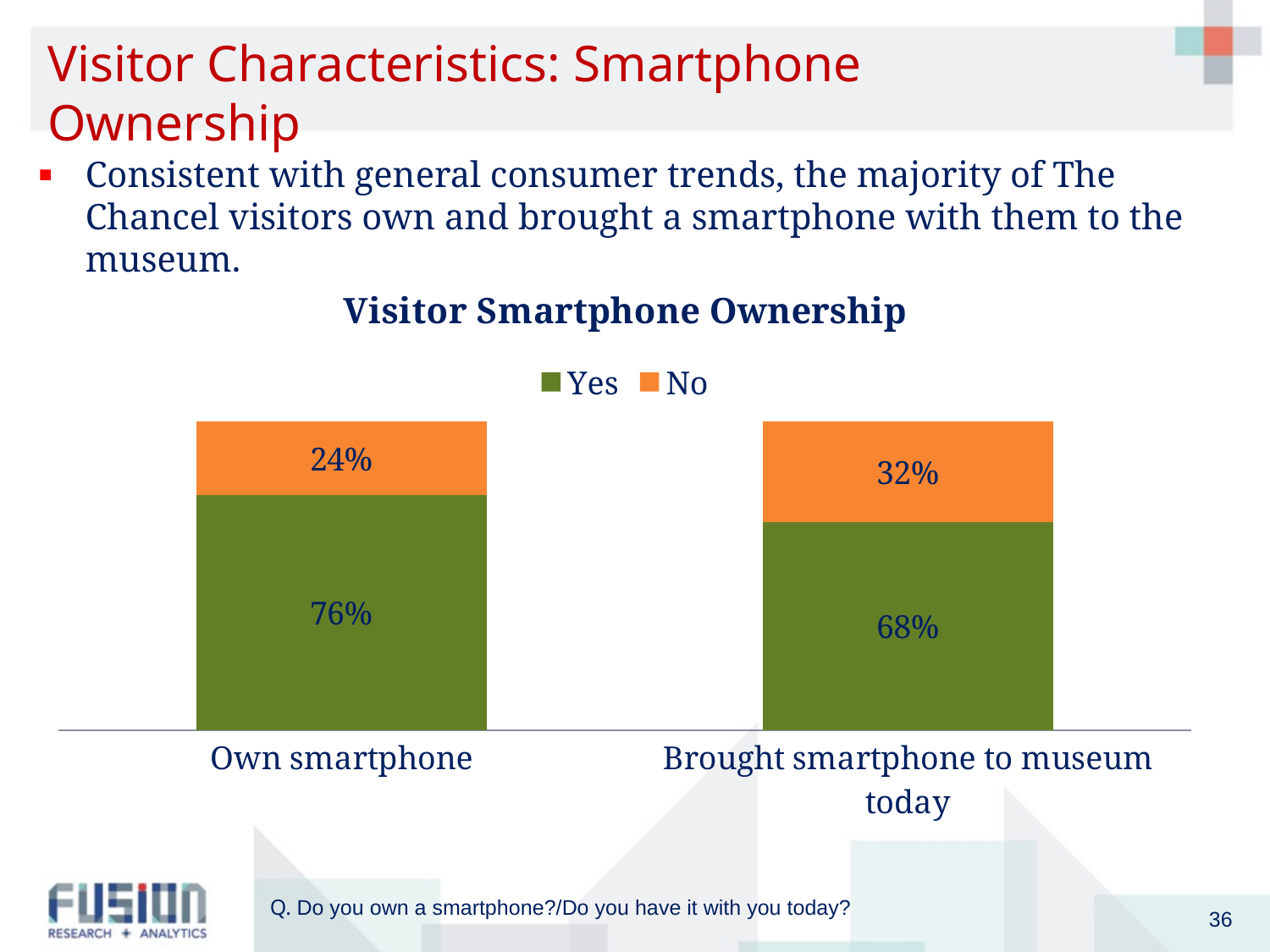
Which category has the lower No percentage? Own smartphone What percentage of visitors answered Yes to owning a smartphone? 76% What percentage of visitors answered Yes to bringing a smartphone to the museum today? 68% How many series does the legend list? 2 What percentage of visitors answered No to owning a smartphone? 24% What is the difference between the Yes percentage for Own smartphone and the Yes percentage for Brought smartphone to museum today? 8% What kind of chart is shown? Stacked bar chart Is the No percentage larger for Own smartphone or for Brought smartphone to museum today? Brought smartphone to museum today What is the title of the chart? Visitor Smartphone Ownership What percentage of visitors answered No to bringing a smartphone to the museum today? 32% How many categories are shown on the x axis? 2 Which category has the higher Yes percentage? Own smartphone